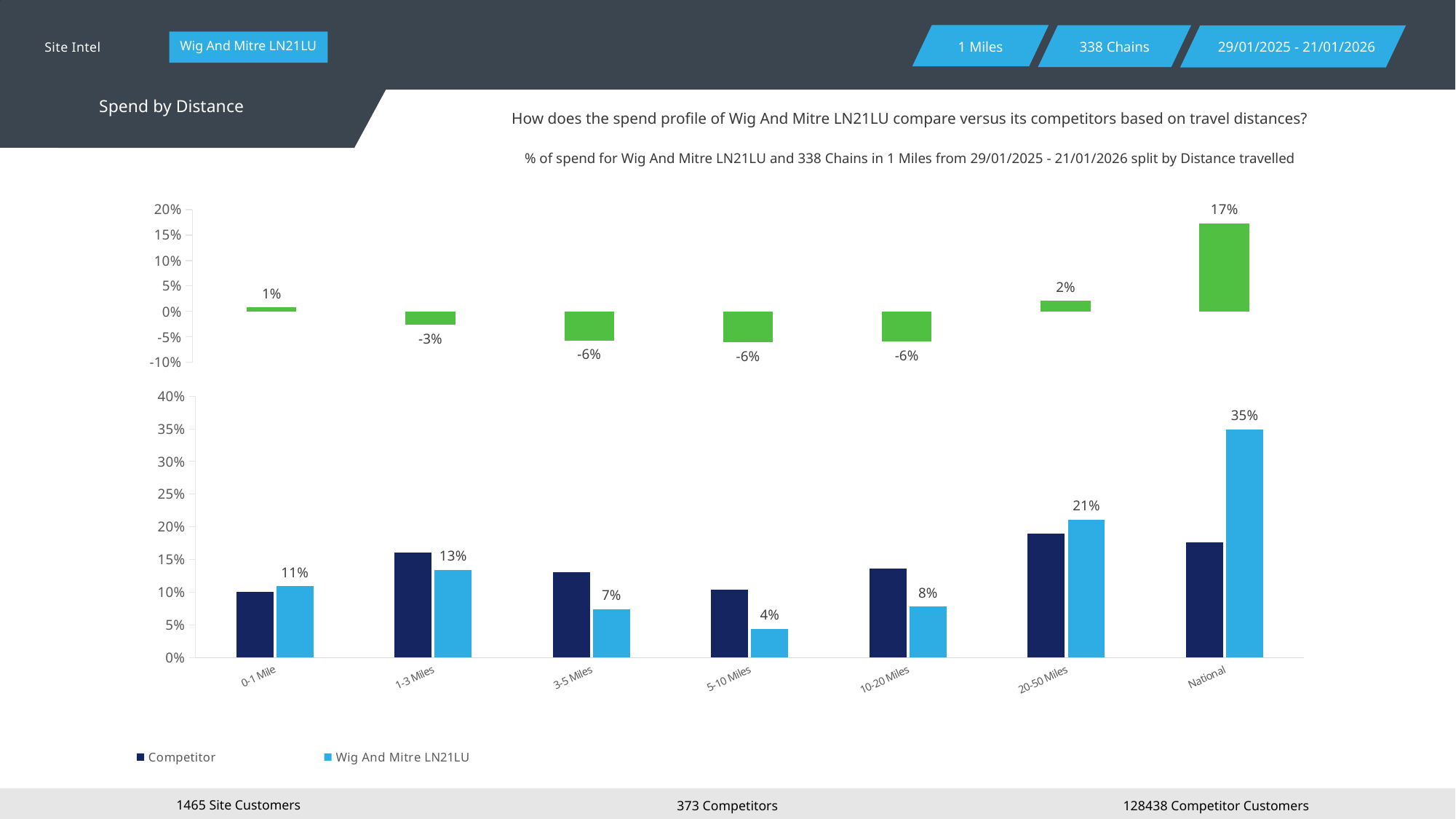
In the bottom chart, what is the value for Wig And Mitre LN21LU at 5-10 Miles? 4% How many series does the legend of the bottom chart list? 2 In the bottom chart, which distance band has the lowest value for Wig And Mitre LN21LU? 5-10 Miles In the top chart, what is the value of the rightmost (National) bar? 17% How many distance bands are shown on the x axis of the bottom chart? 7 In the bottom chart, which is larger at 3-5 Miles: the Competitor bar or the Wig And Mitre LN21LU bar? Competitor What kind of chart is the bottom chart? Bar chart In the bottom chart, what is the value for Wig And Mitre LN21LU at 20-50 Miles? 21% In the bottom chart, which distance band has the highest value for Wig And Mitre LN21LU? National In the bottom chart, what is the difference between the Wig And Mitre LN21LU values at National and 20-50 Miles? 14% In the bottom chart, what is the value for Wig And Mitre LN21LU at National? 35% In the bottom chart, is the Competitor value at National greater or less than 15%? greater